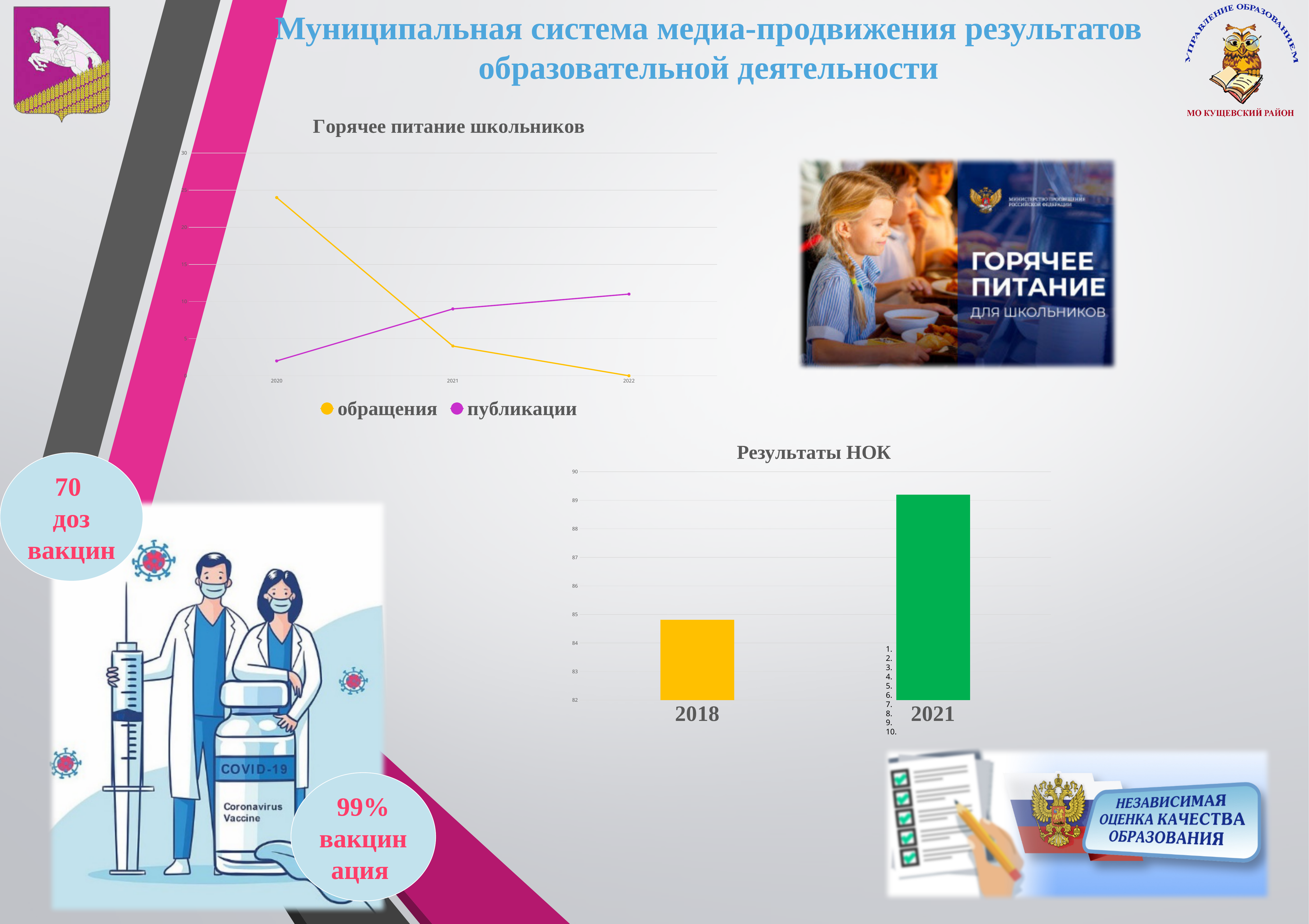
How many series does the legend of "Горячее питание школьников" list? 2 In "Результаты НОК", which year has the higher bar, 2018 or 2021? 2021 In "Горячее питание школьников", is the value for публикации in 2020 greater or less than 5? less In "Горячее питание школьников", which series has the higher value in 2022, обращения or публикации? публикации In "Горячее питание школьников", is the value for обращения in 2020 greater or less than 20? greater In "Горячее питание школьников", does the публикации line rise or fall from 2020 to 2022? rise What kind of chart is "Результаты НОК"? bar chart In "Горячее питание школьников", does the обращения line rise or fall from 2020 to 2022? fall What kind of chart is "Горячее питание школьников"? line chart In "Результаты НОК", is the value for 2018 greater or less than 86? less How many bars are in "Результаты НОК"? 2 How many years are shown on the x axis of "Горячее питание школьников"? 3